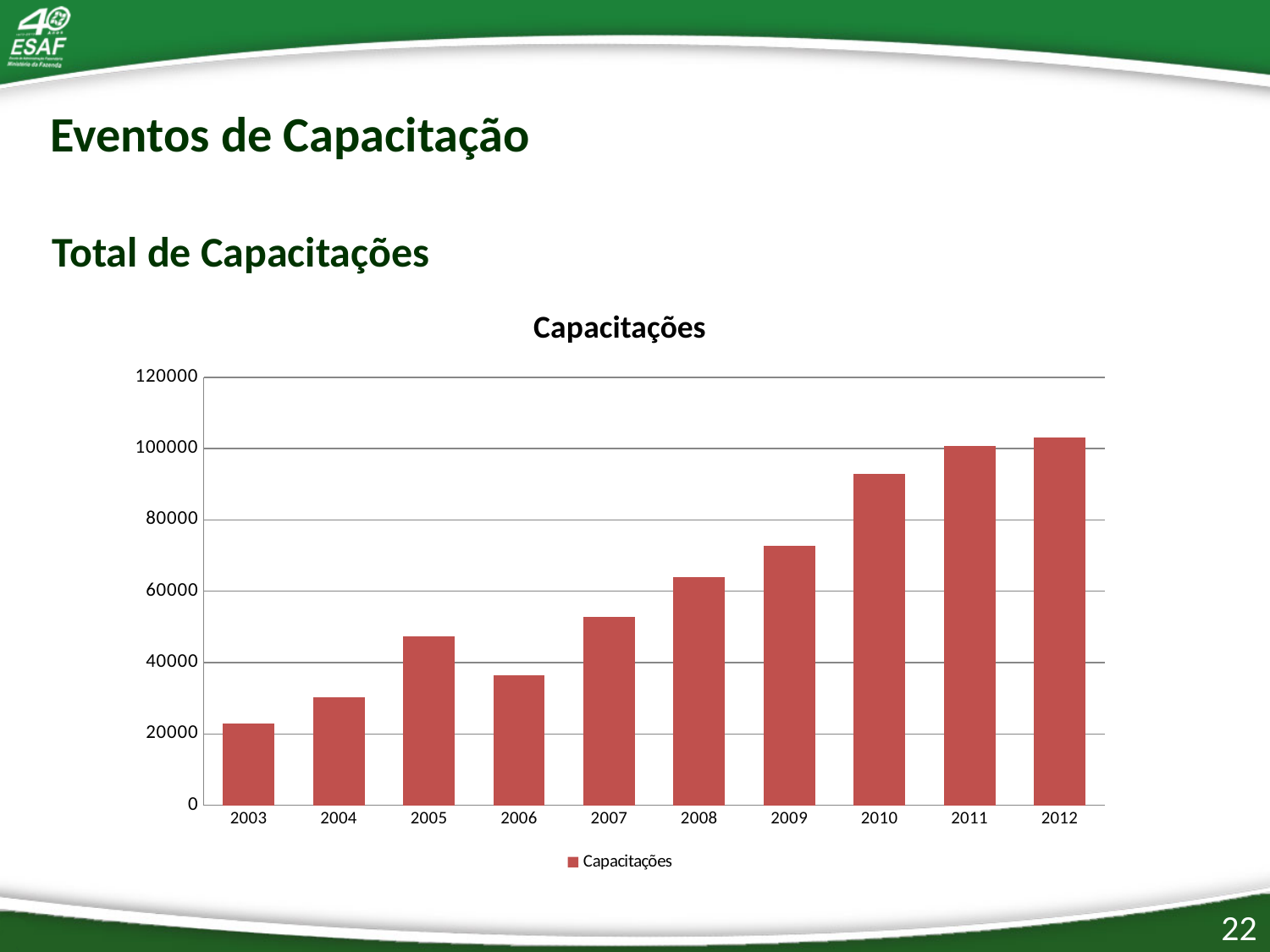
Which year has the larger value, 2005 or 2006? 2005 Do the values generally rise or fall from 2003 to 2012? rise Which year has the larger value, 2009 or 2010? 2010 How many series does the legend list? 1 Is the value for 2010 greater or less than 100000? less Is the value for 2008 greater or less than 60000? greater How many years are shown on the x axis of the chart? 10 Is the value for 2006 greater or less than 40000? less What kind of chart is shown on the slide? bar chart What is the title of the chart? Capacitações Which year has the lowest value in the chart? 2003